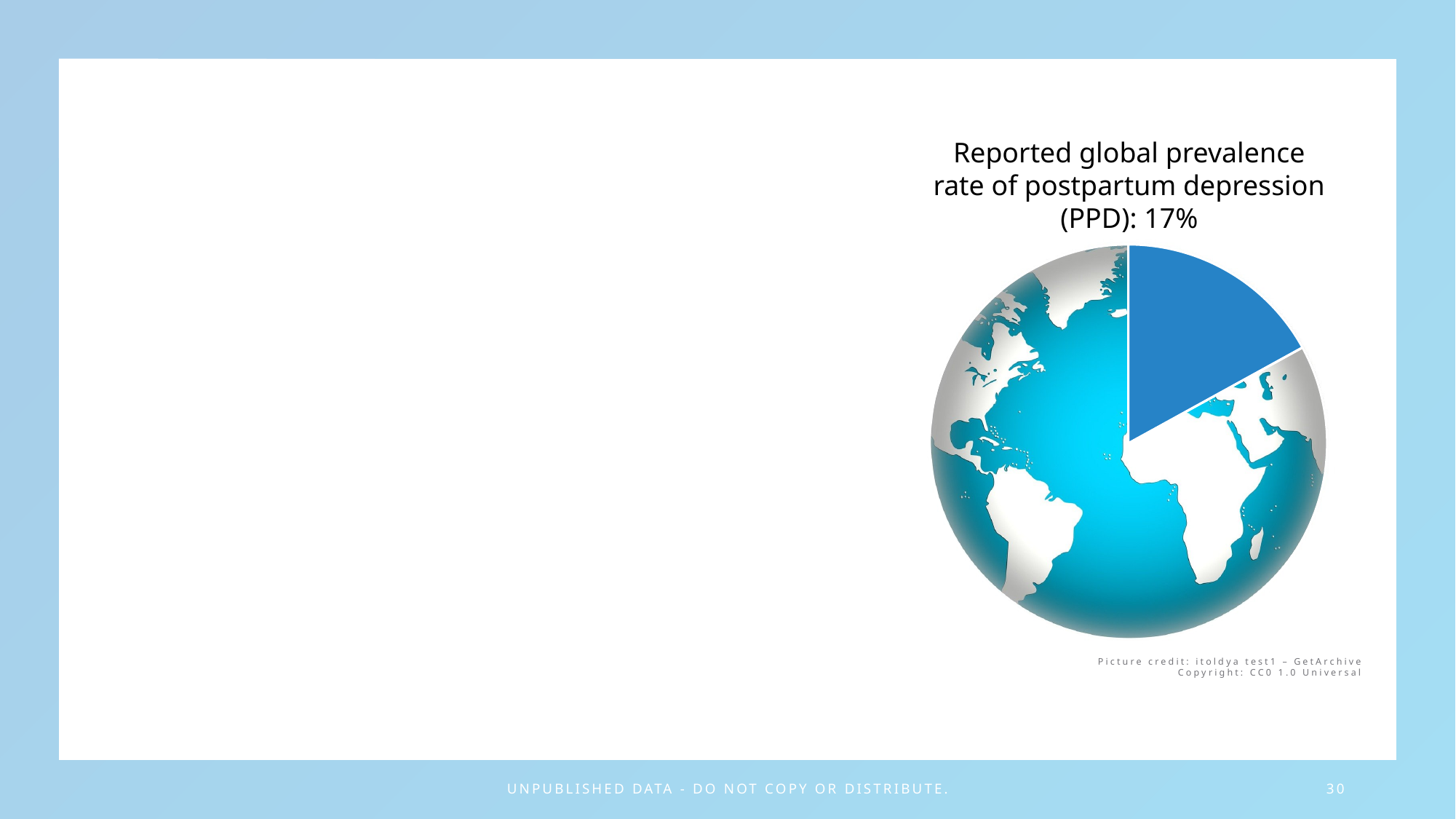
What image is the pie chart overlaid on? a globe What share of the pie does the highlighted slice represent? 17% What is the reported global prevalence rate of postpartum depression (PPD) shown on the chart? 17% What kind of chart is shown on the slide? pie chart Is the highlighted slice of the pie greater or less than 50%? less What is the title of the chart? Reported global prevalence rate of postpartum depression (PPD): 17% Which is larger: the highlighted slice or the remaining portion of the pie? the remaining portion How many slices does the pie chart have? 2